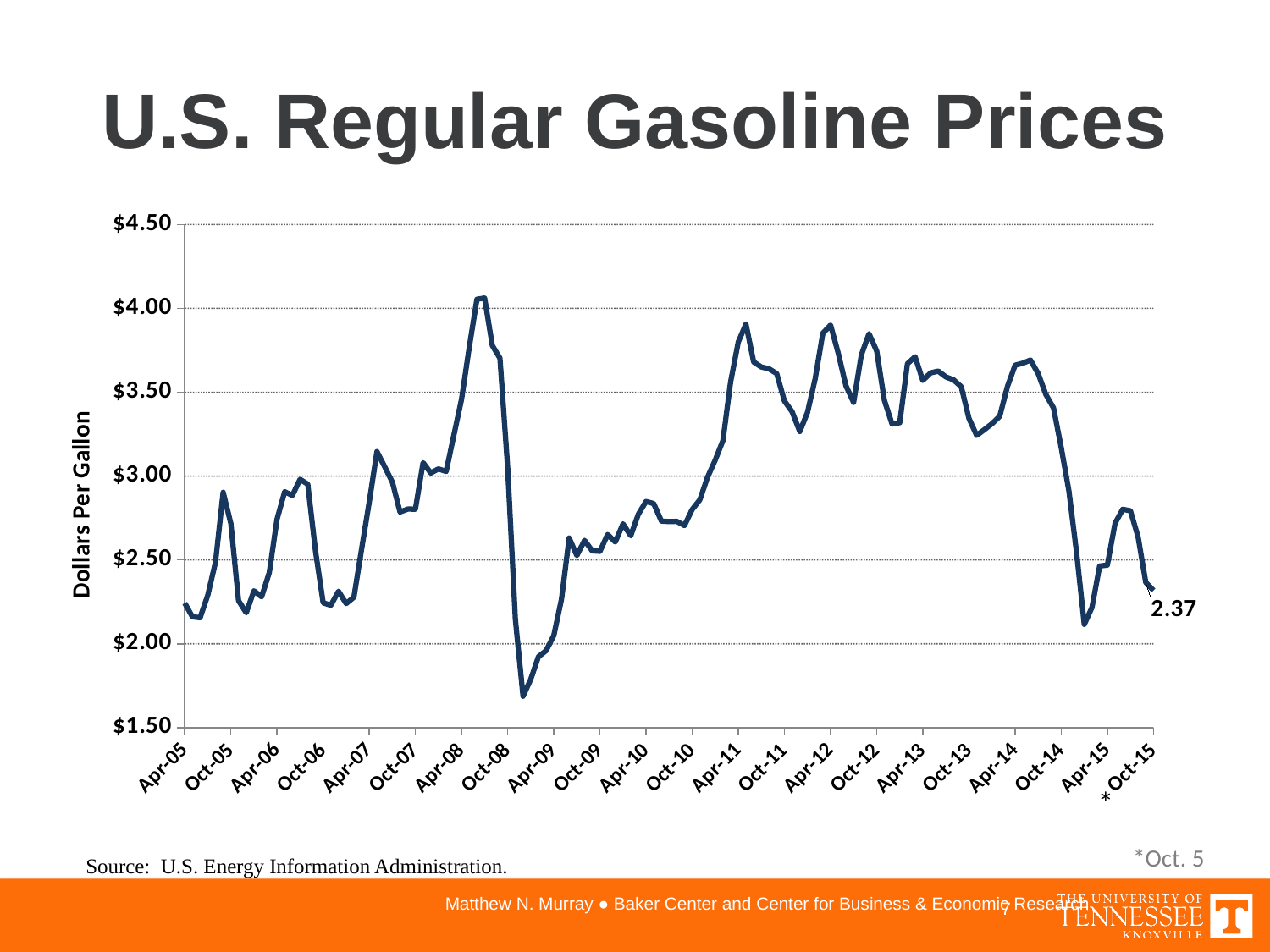
How many data series are plotted on the chart? 1 Is the lowest point on the line greater or less than $2.00? less Is the value for Apr-09 greater or less than $2.50? less Which is higher, the value at Apr-12 or the value at Apr-15? Apr-12 Do gasoline prices rise or fall between Apr-14 and Apr-15? fall Is the value for Apr-11 greater or less than $3.50? greater What kind of chart is shown on the slide? line chart What is the gasoline price shown for the final point, *Oct-15? 2.37 In which year does the line reach its highest point? 2008 What is the label on the vertical axis? Dollars Per Gallon